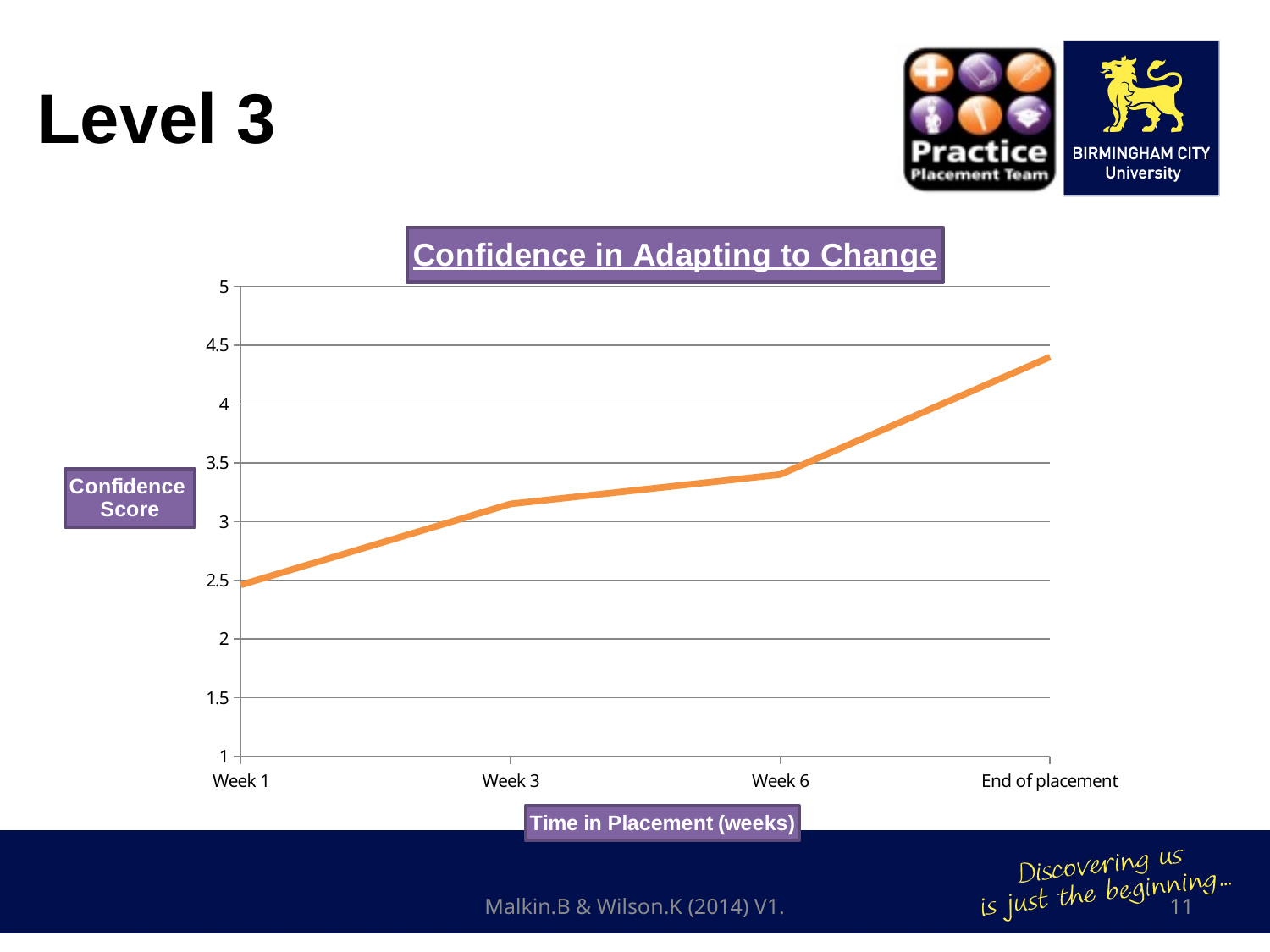
Is the confidence score at Week 3 greater or less than 3? greater Does the confidence score rise or fall from Week 1 to End of placement? rise Which has the higher confidence score, Week 3 or Week 6? Week 6 At which time point is the confidence score highest? End of placement What is the title of the chart? Confidence in Adapting to Change How many time points are plotted along the x axis of the chart? 4 What is the label on the x axis of the chart? Time in Placement (weeks) At which time point is the confidence score lowest? Week 1 Is the confidence score at Week 6 greater or less than 4? less Is the confidence score at End of placement greater or less than 4? greater What kind of chart is shown on the slide? line chart